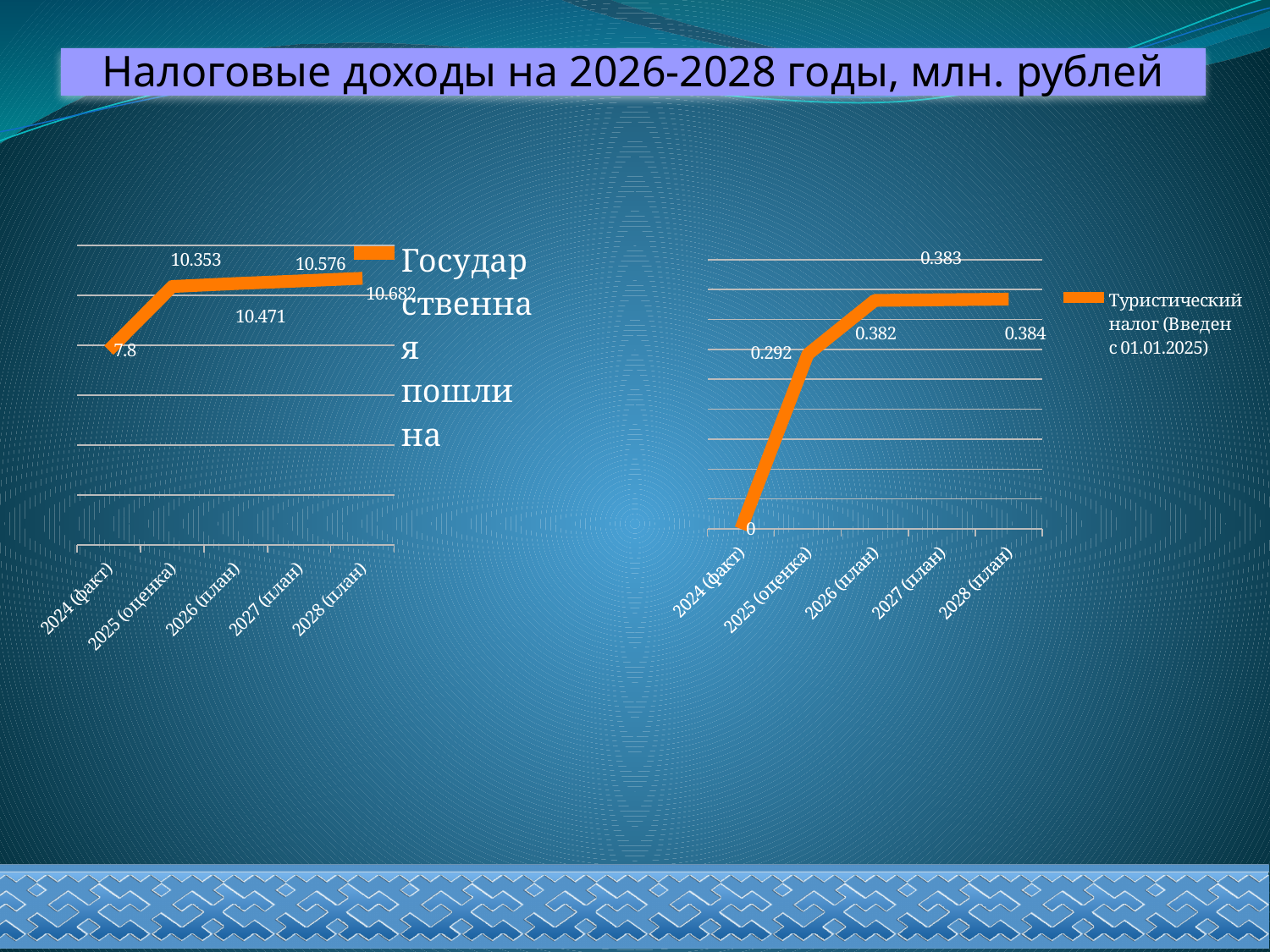
On the left chart, what is the value for 2028 (план)? 10.682 On the left chart, what is the value for 2026 (план)? 10.471 What kind of chart is the left chart? Line chart On the left chart, which category has the lowest value? 2024 (факт) On the left chart, what is the difference between the values for 2025 (оценка) and 2024 (факт)? 2.553 On the right chart, what is the value for 2025 (оценка)? 0.292 On the left chart, what is the value for 2024 (факт)? 7.8 How many categories are shown on the x axis of the right chart? 5 What is the legend entry of the right chart? Туристический налог (Введен с 01.01.2025) On the right chart, what is the value for 2028 (план)? 0.384 On the right chart, which is larger: the value for 2025 (оценка) or the value for 2026 (план)? 2026 (план) On the right chart, which category has the lowest value? 2024 (факт)